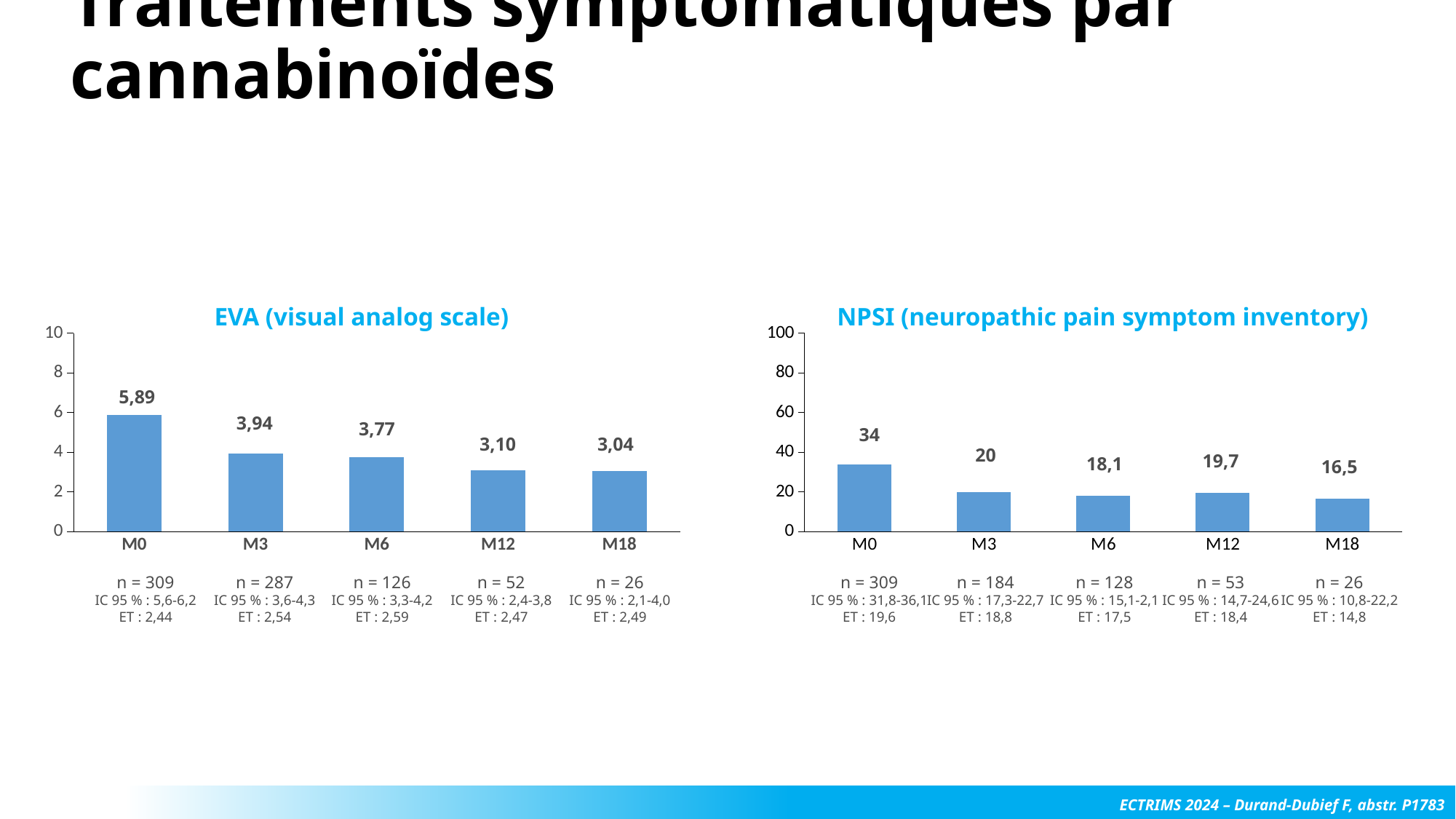
In the EVA (visual analog scale) chart, which time point has the lowest value? M18 What kind of chart is the EVA (visual analog scale) chart? Bar chart What is the title of the chart on the right of the slide? NPSI (neuropathic pain symptom inventory) In the EVA (visual analog scale) chart, what is the difference between the values at M0 and M3? 1,95 In the NPSI (neuropathic pain symptom inventory) chart, which time point has the highest value? M0 In the NPSI (neuropathic pain symptom inventory) chart, what is the value at M6? 18,1 In the EVA (visual analog scale) chart, what is the value at M0? 5,89 In the EVA (visual analog scale) chart, do the values rise or fall from M0 to M18? Fall In the EVA (visual analog scale) chart, is the value at M0 greater or less than 4? greater In the NPSI (neuropathic pain symptom inventory) chart, what is the difference between the values at M12 and M18? 3,2 How many time points are shown in the NPSI (neuropathic pain symptom inventory) chart? 5 In the NPSI (neuropathic pain symptom inventory) chart, which is larger, the value at M6 or the value at M12? M12